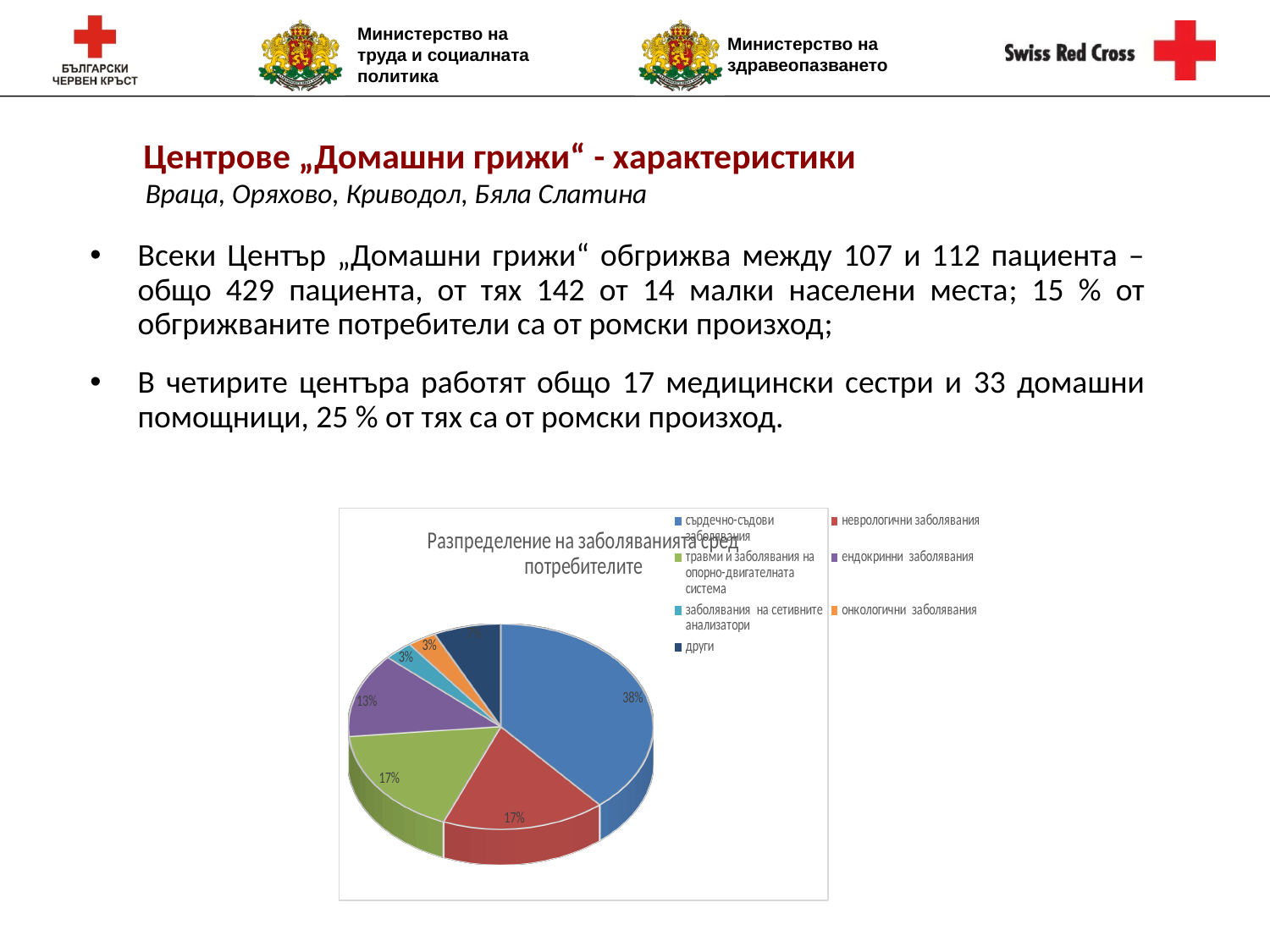
What kind of chart is shown on the slide? pie chart What is the difference in percentage points between сърдечно-съдови заболявания and ендокринни заболявания? 25 percentage points What share of the pie is labelled for сърдечно-съдови заболявания? 38% What percentage is shown for травми и заболявания на опорно-двигателната система? 17% What percentage is shown for ендокринни заболявания? 13% How many categories does the legend list? 7 What is the title of the chart? Разпределение на заболяванията сред потребителите What percentage is shown for онкологични заболявания? 3% Which is larger: the share for ендокринни заболявания or for травми и заболявания на опорно-двигателната система? травми и заболявания на опорно-двигателната система What percentage is shown for неврологични заболявания? 17% What colour is the slice for сърдечно-съдови заболявания? blue Which category has the largest slice of the pie? сърдечно-съдови заболявания